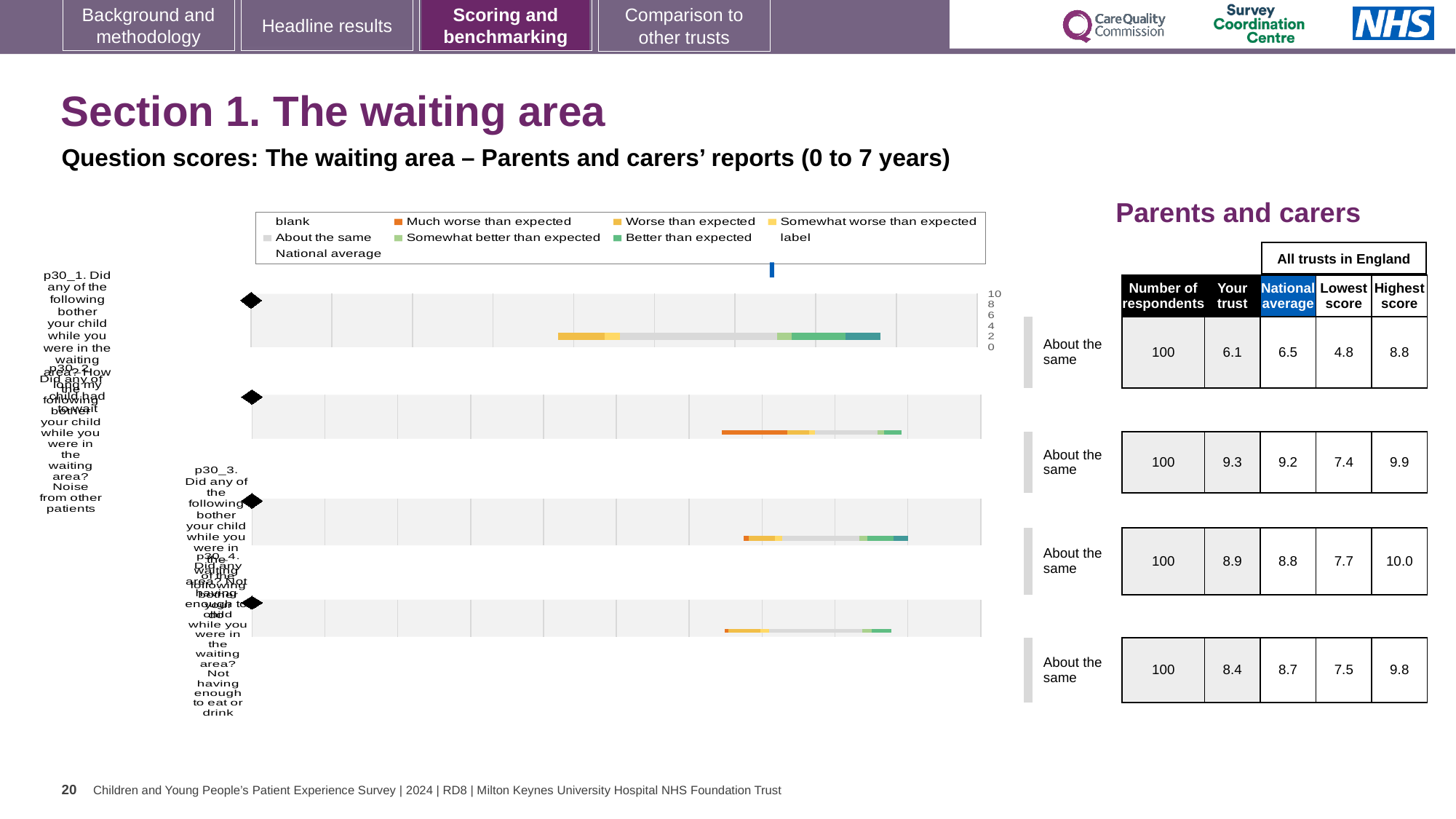
For the first row in the table, what is the difference between the national average (6.5) and the 'Your trust' score (6.1)? 0.4 In the chart legend, what colour represents 'Much worse than expected'? orange What kind of chart is shown on the slide? bar chart In the table next to the chart, what is the highest score for the third row? 10.0 In the table next to the chart, which row has the highest 'Your trust' score? the second row (9.3) What benchmark label is shown to the right of each bar in the chart? About the same For the first row in the table, which is larger: the 'Your trust' score or the national average? national average In the table next to the chart, what is the 'Your trust' score for the first row (p30_1, waiting area bother)? 6.1 In the table next to the chart, what is the number of respondents for each row? 100 In the table next to the chart, which row has the lowest 'Your trust' score? the first row (6.1) In the table next to the chart, what is the national average for the first row (p30_1)? 6.5 How many horizontal bars (questions) are plotted in the chart? 4